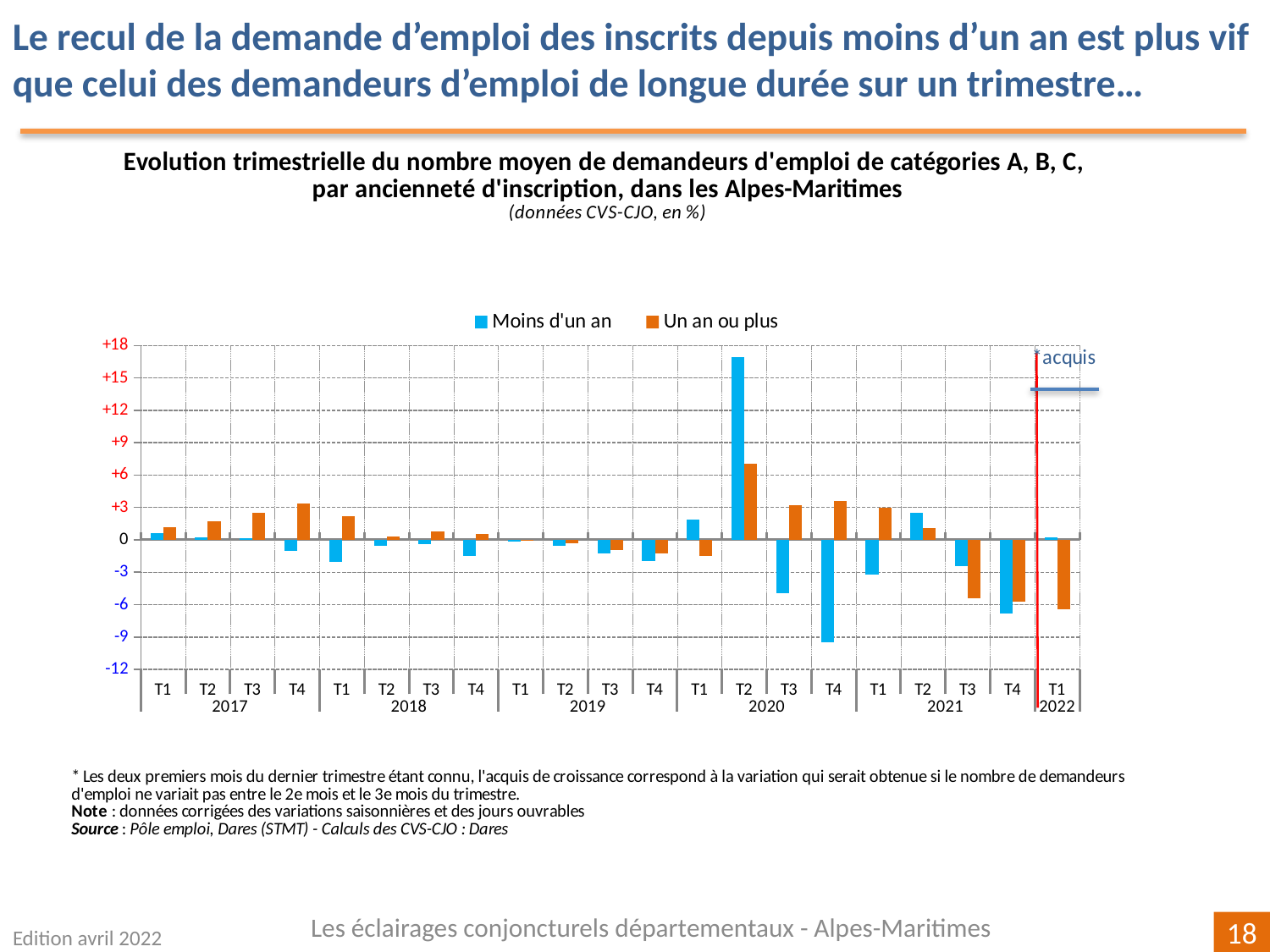
How many quarters are plotted along the x axis? 21 In which quarter does the 'Moins d'un an' series reach its lowest value? T4 2020 In which quarter does the 'Un an ou plus' series reach its highest value? T2 2020 Is the value for 'Un an ou plus' in T1 2022 greater or less than -3? less Which quarter on the x axis is marked with the 'acquis' annotation? T1 2022 How many series does the legend list? 2 In T2 2020, which series has the larger value, 'Moins d'un an' or 'Un an ou plus'? Moins d'un an In which quarter does the 'Moins d'un an' series reach its highest value? T2 2020 What are the two series named in the legend? Moins d'un an; Un an ou plus Is the value for 'Moins d'un an' in T2 2020 greater or less than +15? greater Is the value for 'Moins d'un an' in T4 2020 greater or less than -6? less What kind of chart is shown on the slide? bar chart